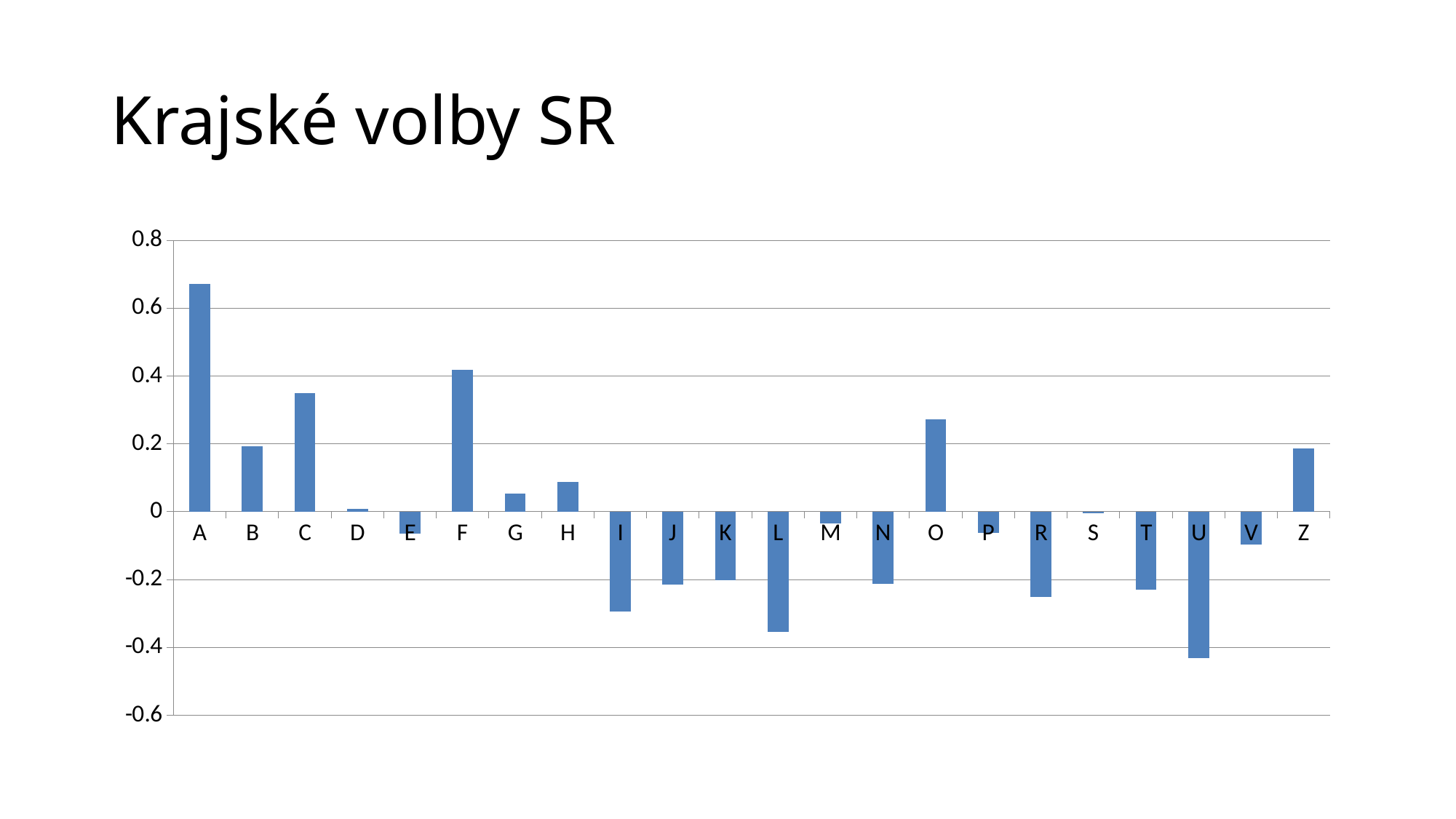
Which has the larger value, C or O? C Is the value for C greater or less than 0.4? less What is the title of the slide? Krajské volby SR Which has the larger value, A or F? A Which category has the lowest value? U Is the value for U greater or less than -0.4? less Is the value for A greater or less than 0.6? greater What kind of chart is shown on the slide? bar chart Which category has the highest value? A How many categories are plotted on the x axis? 22